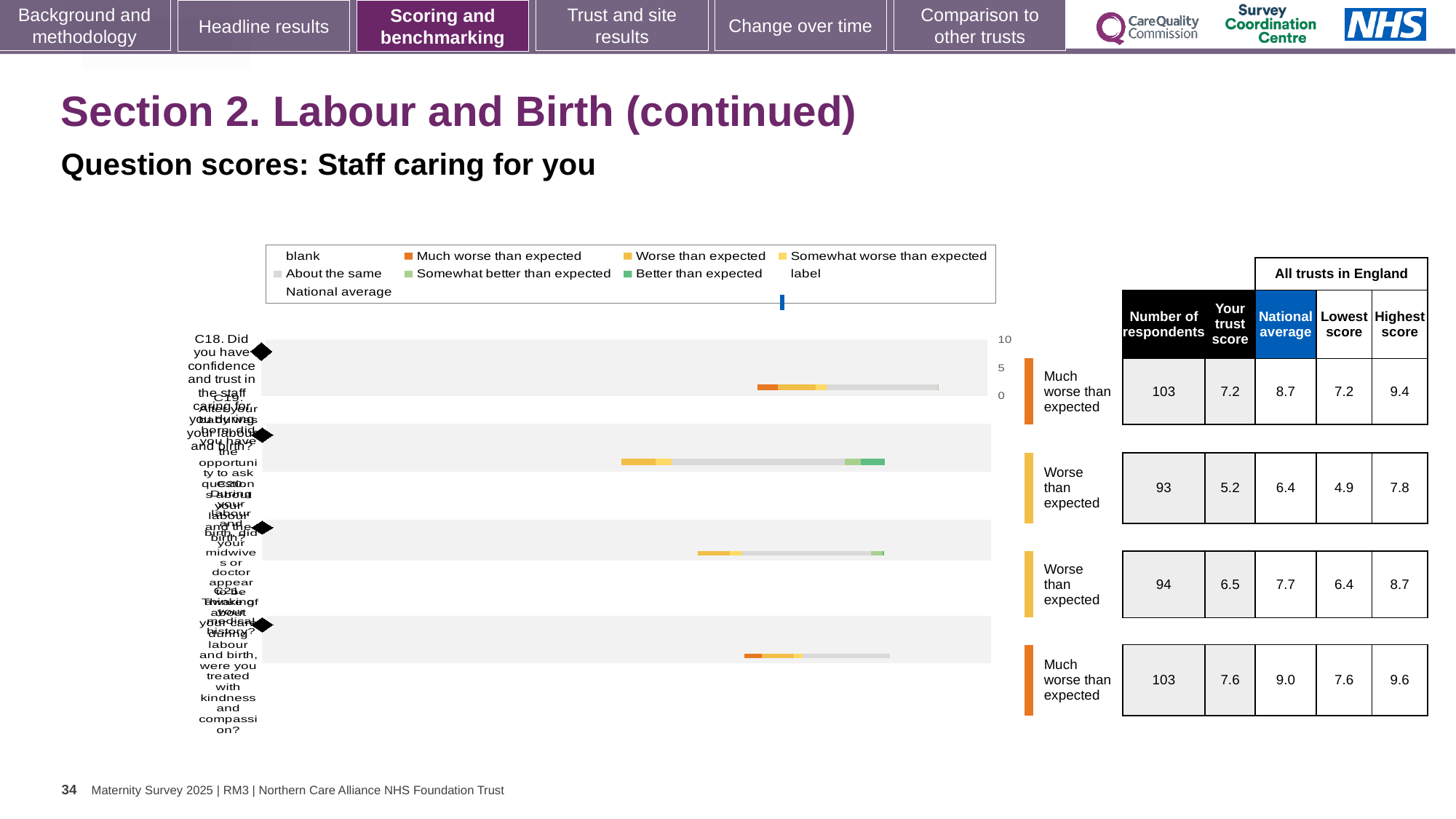
What kind of chart is shown on the slide? Horizontal bar chart What is the national average for question C19 (opportunity to ask questions about your labour and birth)? 6.4 Which question has the lowest trust score? C19 Which benchmark category is question C19 placed in? Worse than expected For question C21, what is the difference between the national average and the trust score? 1.4 Which question has the highest trust score? C21 What is the highest score among all trusts in England for question C21? 9.6 What is the subtitle describing the question scores shown in the chart? Question scores: Staff caring for you How many questions (categories) are plotted in the chart? 4 What is the trust score for question C18 (confidence and trust in the staff caring for you)? 7.2 Which has the larger trust score, question C18 or question C20? C18 How many respondents answered question C20? 94